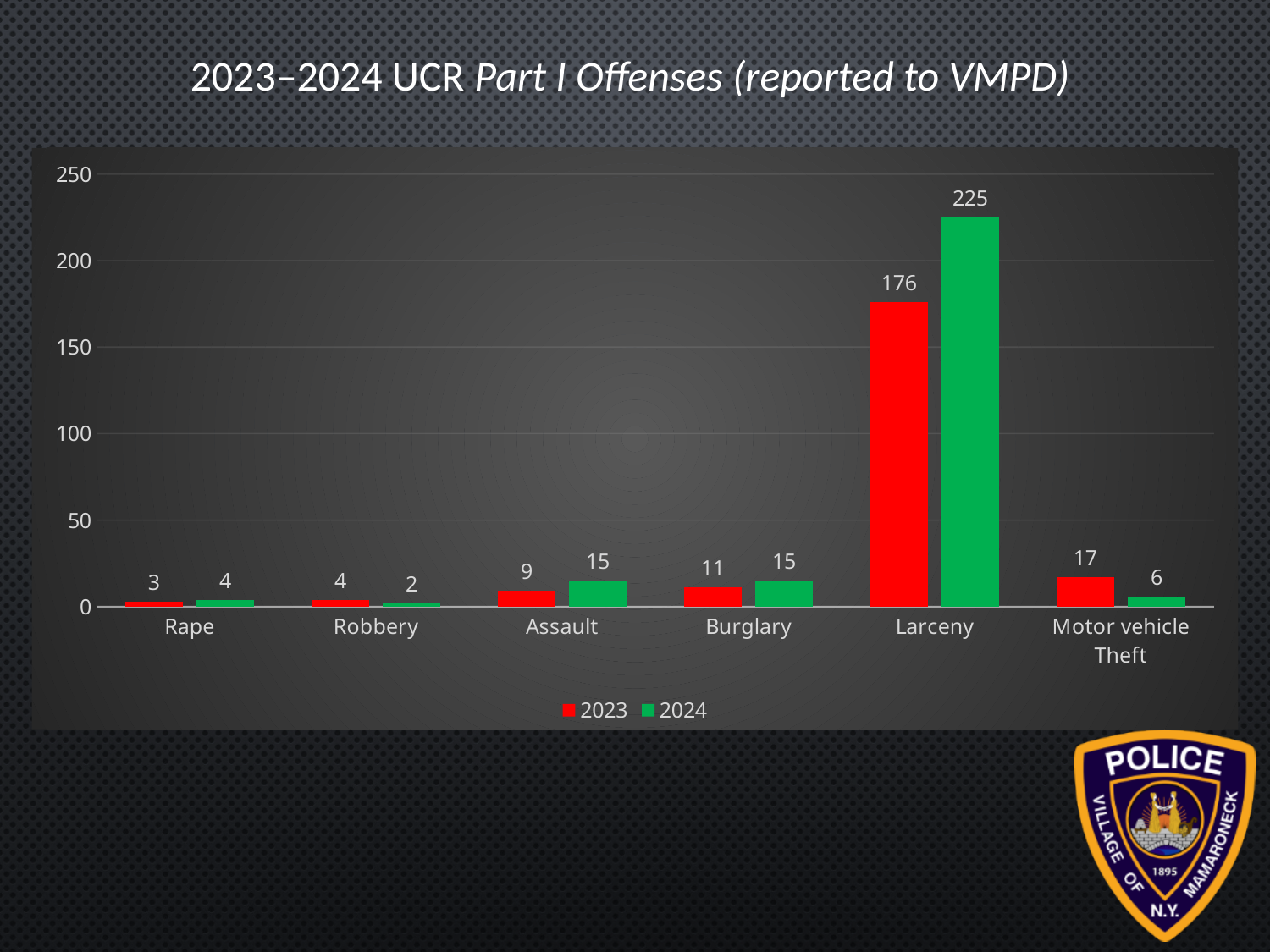
What colour represents the 2024 series? green What is the difference between the 2024 and 2023 values for Larceny? 49 Which category has the lowest 2024 value? Robbery How many offense categories are shown on the x axis? 6 What is the 2024 value for Larceny? 225 What is the 2023 value for Assault? 9 What is the 2023 value for Motor vehicle Theft? 17 What kind of chart is shown on the slide? bar chart Is the 2023 value for Larceny greater or less than 150? greater Which is larger for Motor vehicle Theft, the 2023 value or the 2024 value? 2023 How many series does the legend list? 2 Which category has the highest 2023 value? Larceny